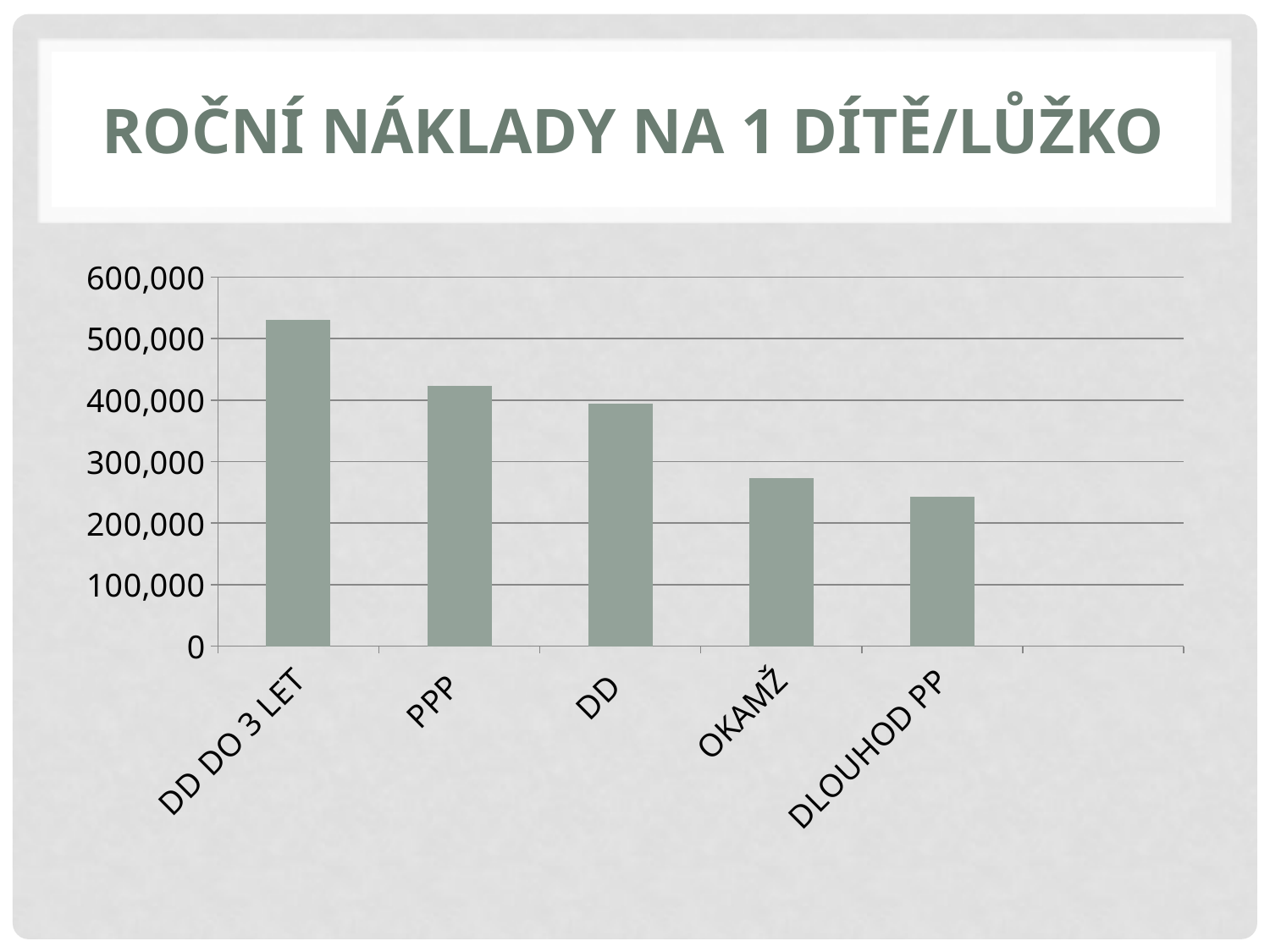
How many categories are plotted in the chart? 5 Which is larger, the value for PPP or the value for OKAMŽ? PPP What kind of chart is shown on the slide? bar chart Is the value for DLOUHOD PP greater or less than 200,000? greater Is the value for DD DO 3 LET greater or less than 500,000? greater What is the title of the chart? ROČNÍ NÁKLADY NA 1 DÍTĚ/LŮŽKO Which category has the highest value? DD DO 3 LET Which category has the lowest value? DLOUHOD PP Do the values rise or fall from left to right along the x axis? fall Is the value for OKAMŽ greater or less than 300,000? less